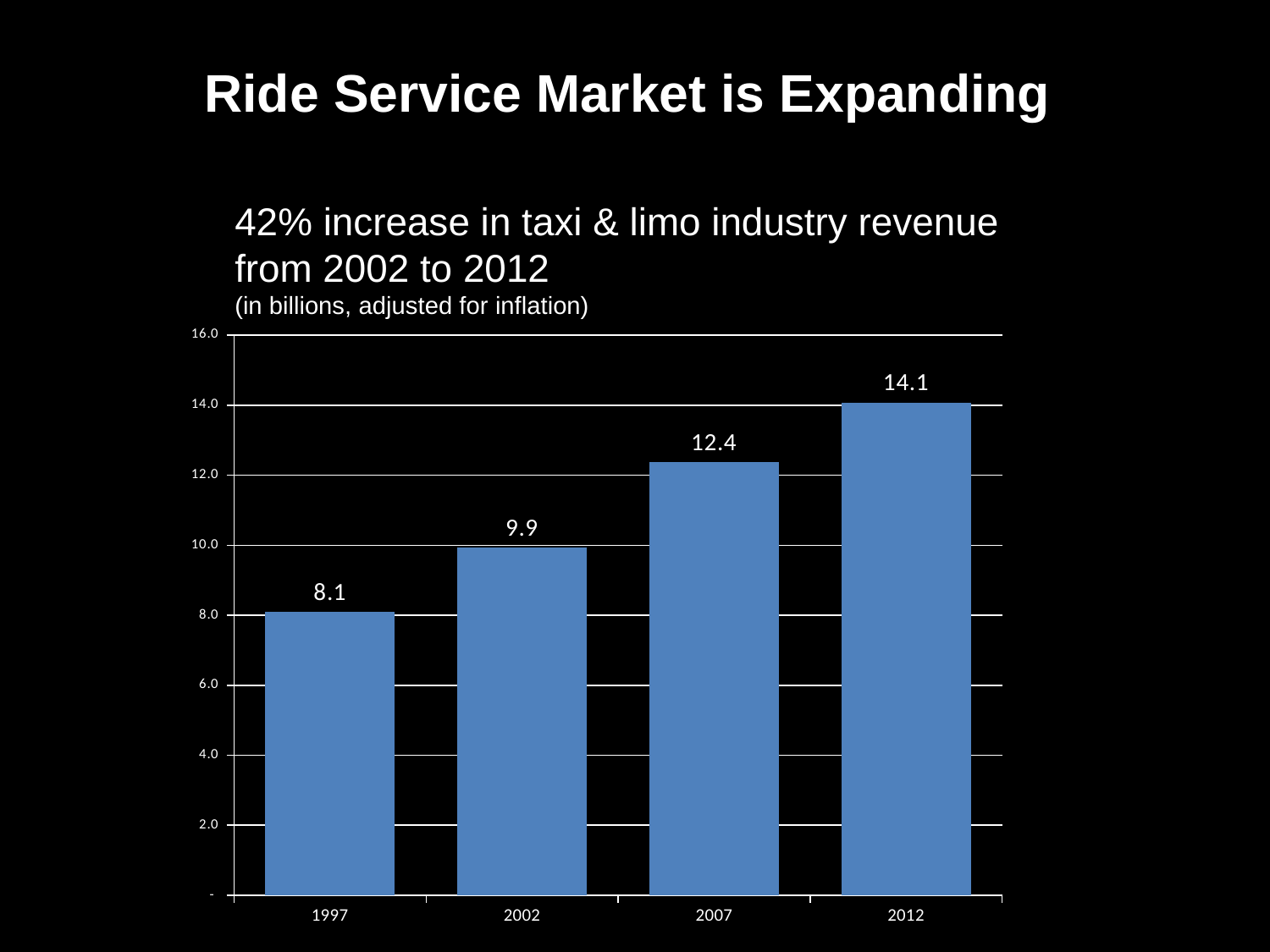
What is the value for 2002? 9.9 What is the value for 2012? 14.1 What is the difference between the values for 2012 and 2002? 4.2 What is the difference between the values for 2007 and 1997? 4.3 Which is larger, the value for 2007 or the value for 2002? 2007 Which year has the lowest value? 1997 Is the value for 2007 greater or less than 12.0? greater What kind of chart is shown on the slide? bar chart What is the value for 1997? 8.1 Do the values rise or fall from 1997 to 2012? rise How many years are shown on the x axis? 4 Which year has the highest value? 2012